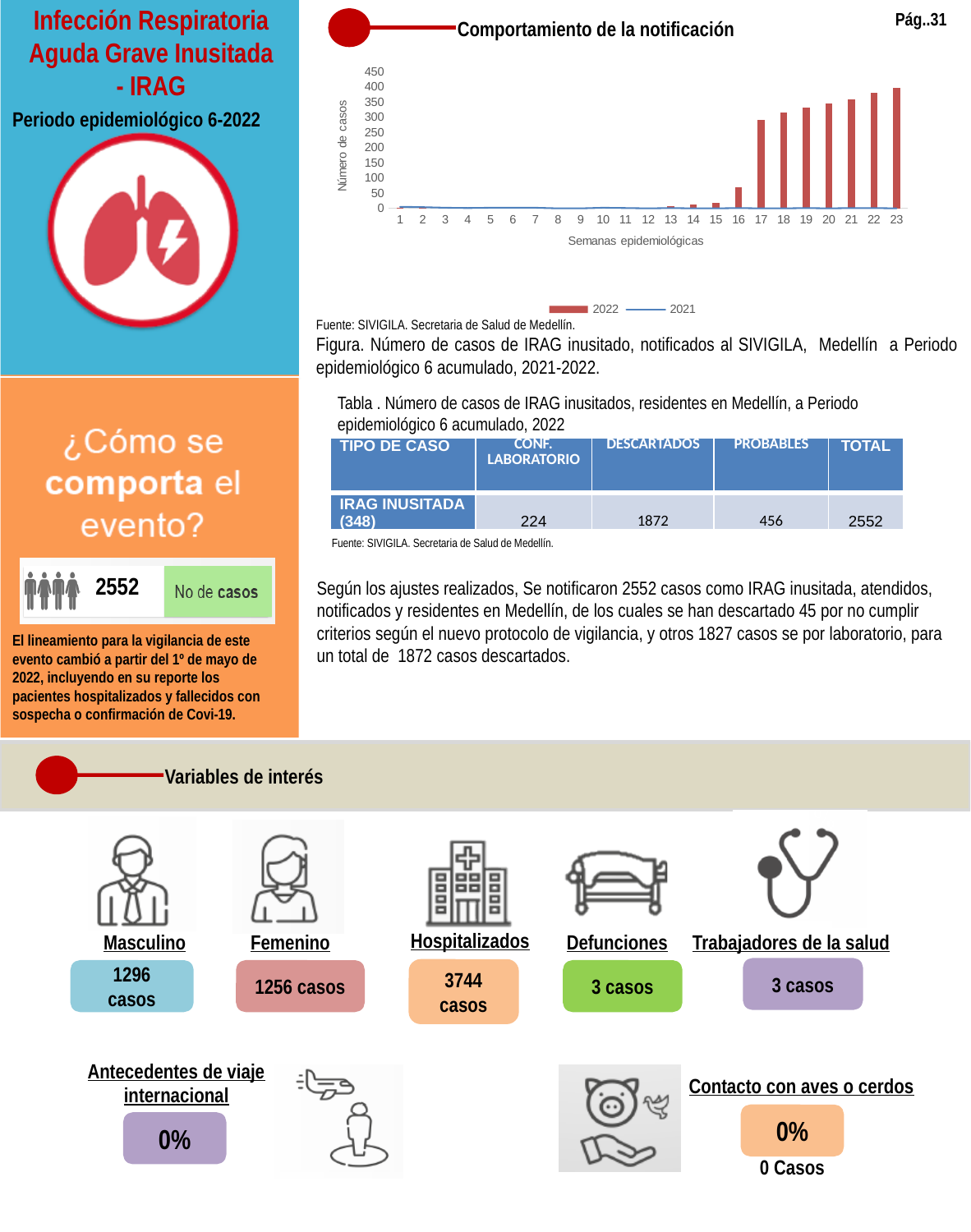
Which two series are listed in the legend of the 'Comportamiento de la notificación' chart? 2022 and 2021 In the 'Comportamiento de la notificación' chart, is the 2022 value for week 14 greater or less than 50? less In the 'Comportamiento de la notificación' chart, which is larger for 2022: week 17 or week 23? week 23 What kind of chart is used in 'Comportamiento de la notificación'? combination bar and line chart What is the y-axis label of the 'Comportamiento de la notificación' chart? Número de casos In the 'Comportamiento de la notificación' chart, do the 2022 bars rise or fall from week 17 to week 23? rise How many series does the legend of the 'Comportamiento de la notificación' chart list? 2 In the 'Comportamiento de la notificación' chart, which week has the highest 2022 bar? 23 How many epidemiological weeks are shown on the x axis of the 'Comportamiento de la notificación' chart? 23 In the 'Comportamiento de la notificación' chart, is the 2022 value for week 17 greater or less than 250? greater In the 'Comportamiento de la notificación' chart, is the 2022 value for week 16 greater or less than 100? less